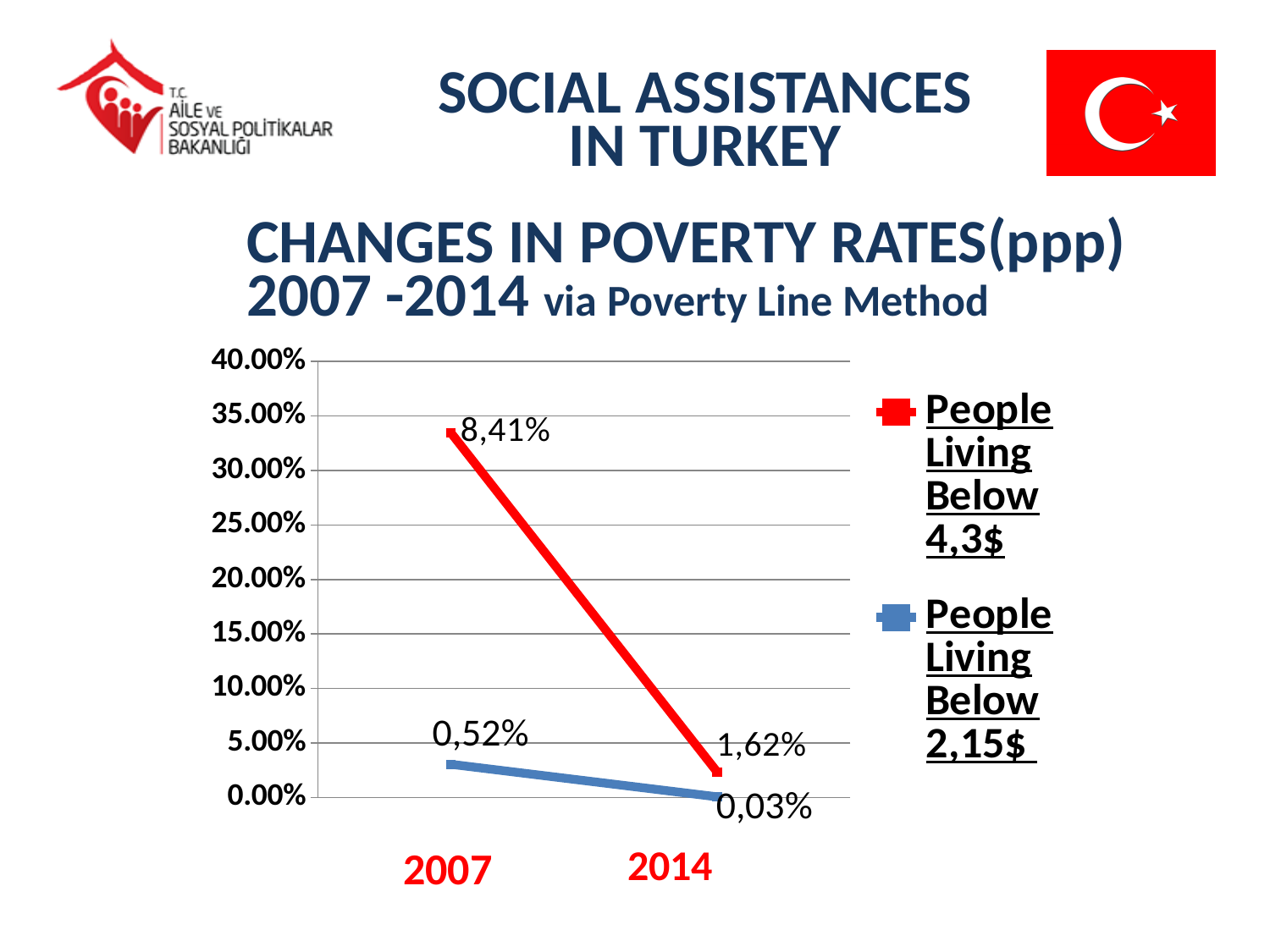
Is the value for People Living Below 2,15$ in 2014 greater or less than 5.00%? less How many series does the legend list? 2 What is the data label for People Living Below 4,3$ in 2014? 1,62% What is the data label for People Living Below 4,3$ in 2007? 8,41% What is the data label for People Living Below 2,15$ in 2014? 0,03% What is the data label for People Living Below 2,15$ in 2007? 0,52% How many years are shown on the x axis? 2 Does the People Living Below 4,3$ line rise or fall from 2007 to 2014? Fall By how much did the labelled value for People Living Below 2,15$ decrease from 2007 to 2014? 0,49% Which series has the higher value in 2007, People Living Below 4,3$ or People Living Below 2,15$? People Living Below 4,3$ What type of chart is shown on the slide? Line chart What colour is the line for People Living Below 2,15$? Blue